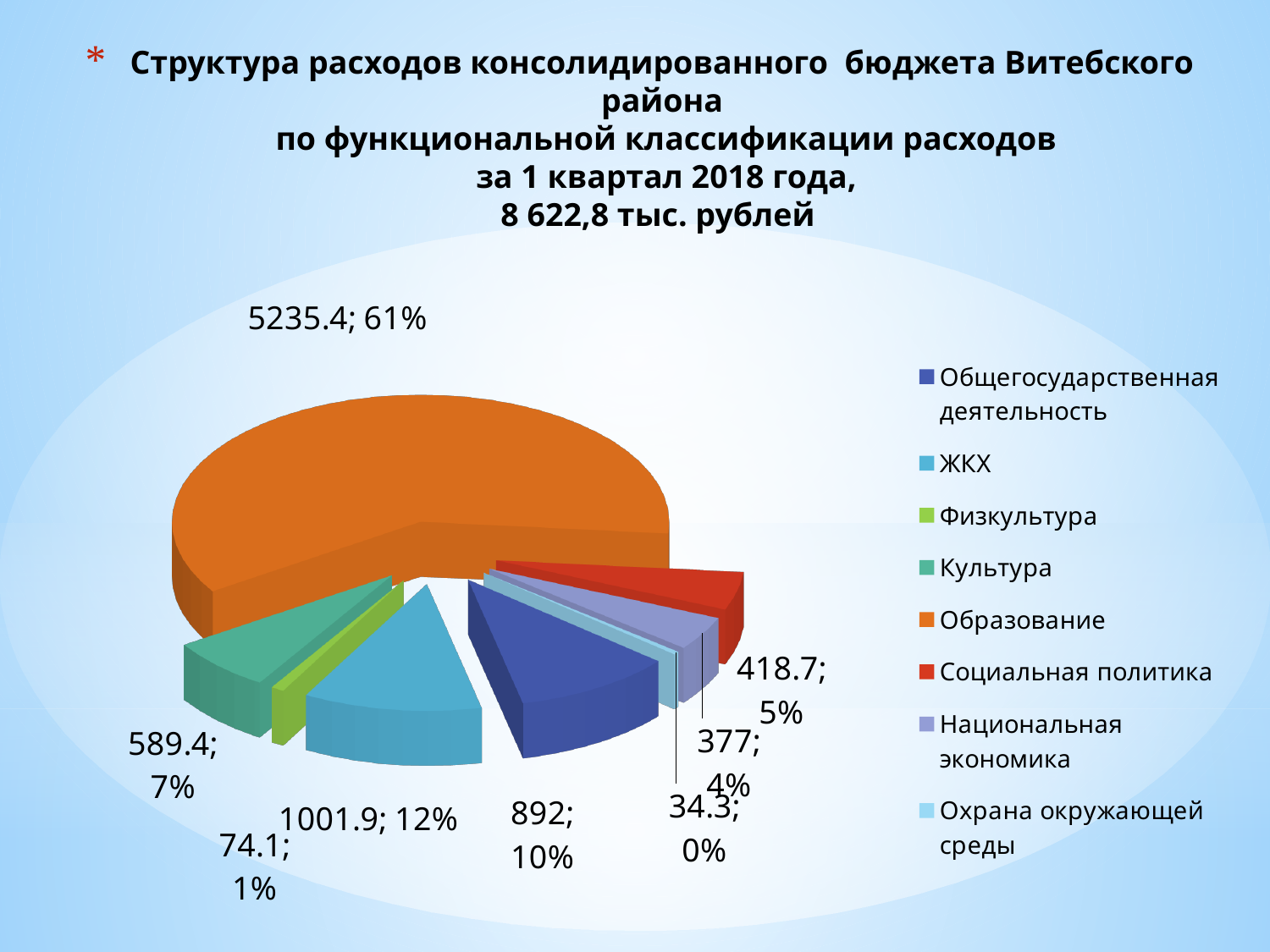
What kind of chart is shown on the slide? pie chart What value is shown for Образование in the pie chart? 5235.4 What share of the pie does Образование account for? 61% What share of the pie does Общегосударственная деятельность account for? 10% Which is larger, the value for Культура or the value for Физкультура? Культура What is the difference between the values for Социальная политика and Национальная экономика? 41.7 Which category has the smallest slice of the pie? Охрана окружающей среды What value is shown for ЖКХ in the pie chart? 1001.9 What total amount in thousand rubles is stated in the chart title? 8 622,8 тыс. рублей How many categories does the legend of the pie chart list? 8 Which category has the largest slice of the pie? Образование What share of the pie does Национальная экономика account for? 4%